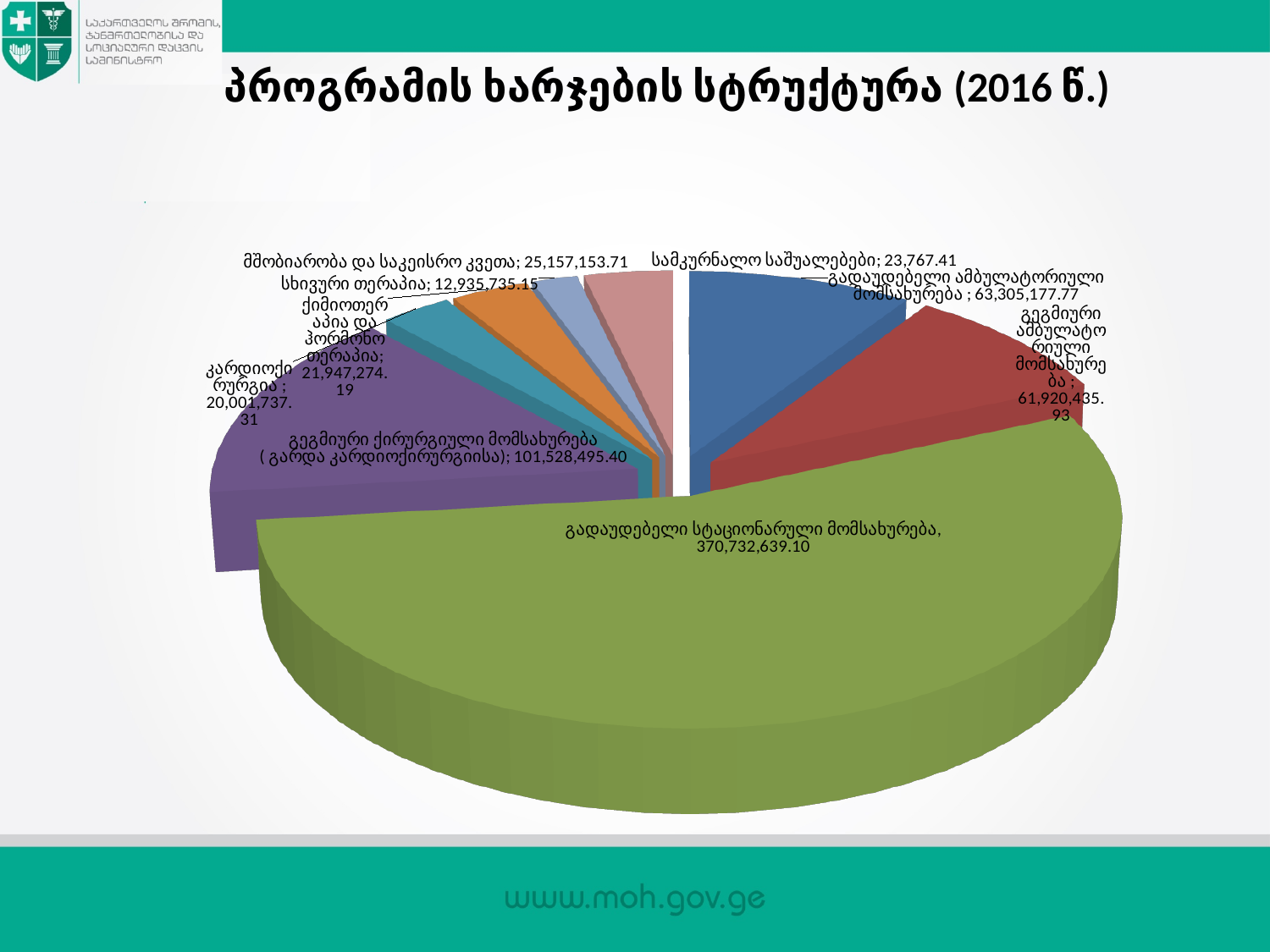
Which category has the largest slice of the pie? გადაუდებელი სტაციონარული მომსახურება How many slices does the pie chart have? 9 Which is larger: გადაუდებელი ამბულატორიული მომსახურება or გეგმიური ამბულატორიული მომსახურება? გადაუდებელი ამბულატორიული მომსახურება What is the value for გადაუდებელი სტაციონარული მომსახურება? 370,732,639.10 What is the value for სამკურნალო საშუალებები? 23,767.41 What is the title of the chart on the slide? პროგრამის ხარჯების სტრუქტურა (2016 წ.) What is the value for კარდიოქირურგია? 20,001,737.31 What kind of chart is shown on the slide? pie chart What is the value for გეგმიური ქირურგიული მომსახურება (გარდა კარდიოქირურგიისა)? 101,528,495.40 What is the value for სხივური თერაპია? 12,935,735.15 What is the difference between მშობიარობა და საკეისრო კვეთა and სხივური თერაპია? 12,221,418.56 Which category has the smallest value? სამკურნალო საშუალებები